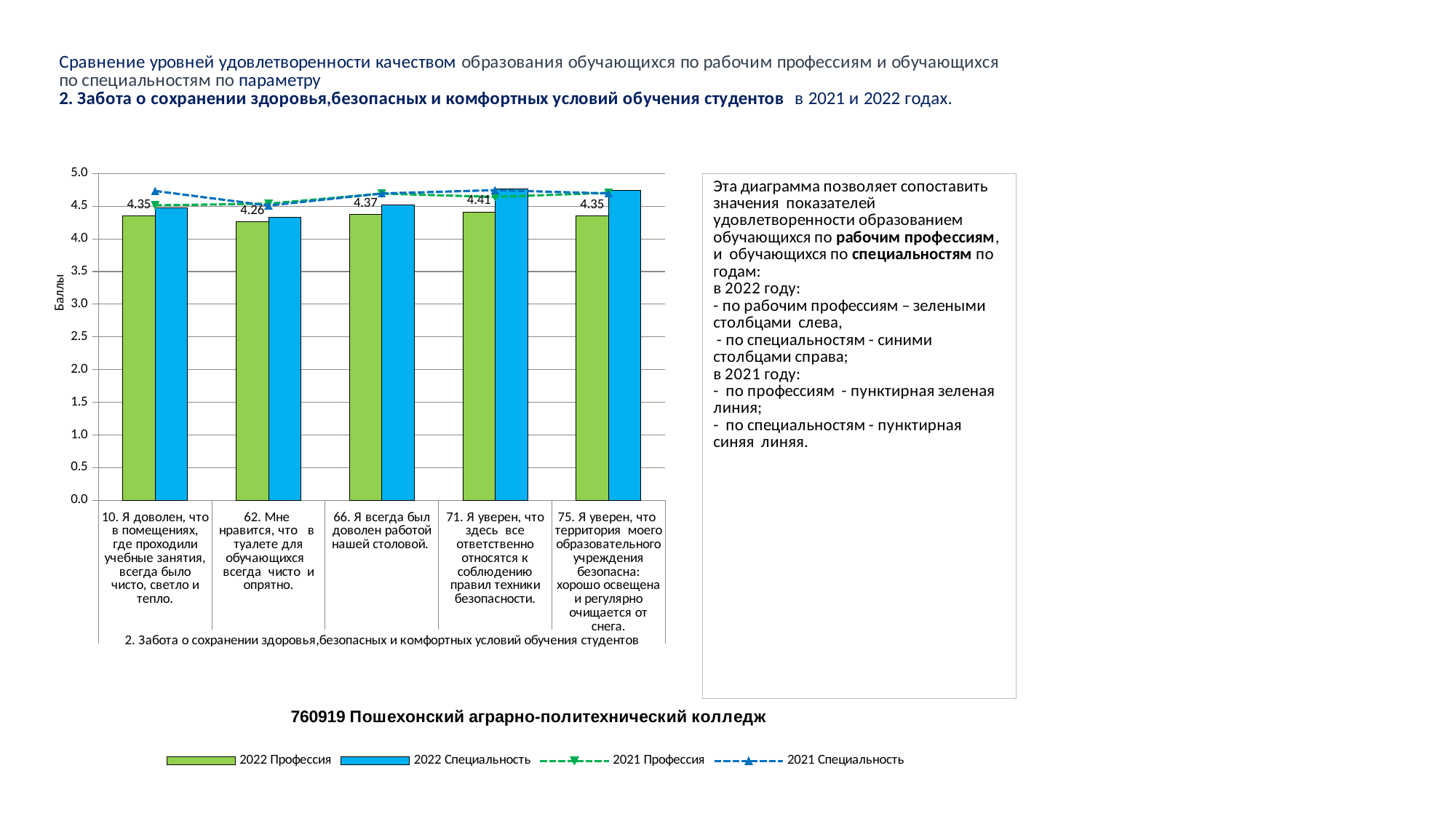
What is the value of the 2022 Профессия bar for category "71. Я уверен, что здесь все ответственно относятся к соблюдению правил техники безопасности."? 4.41 Which category has the lowest 2022 Профессия value? 62. Мне нравится, что в туалете для обучающихся всегда чисто и опрятно. Is the 2022 Специальность value for category 71 (safety rules are followed) greater or less than 4.5? greater How many series does the chart legend list? 4 What is the value of the 2022 Профессия bar for category "62. Мне нравится, что в туалете для обучающихся всегда чисто и опрятно."? 4.26 What is the value of the 2022 Профессия bar for category "10. Я доволен, что в помещениях, где проходили учебные занятия, всегда было чисто, светло и тепло."? 4.35 How many categories are shown on the x axis of the chart? 5 Is the 2022 Специальность value for category 62 (toilets are clean) greater or less than 4.5? less Which category has the highest 2022 Профессия value? 71. Я уверен, что здесь все ответственно относятся к соблюдению правил техники безопасности. For category 75 (territory of the educational institution is safe), which 2022 bar is taller: Профессия or Специальность? 2022 Специальность What is the value of the 2022 Профессия bar for category "66. Я всегда был доволен работой нашей столовой."? 4.37 What is the difference between the highest and lowest 2022 Профессия values? 0.15